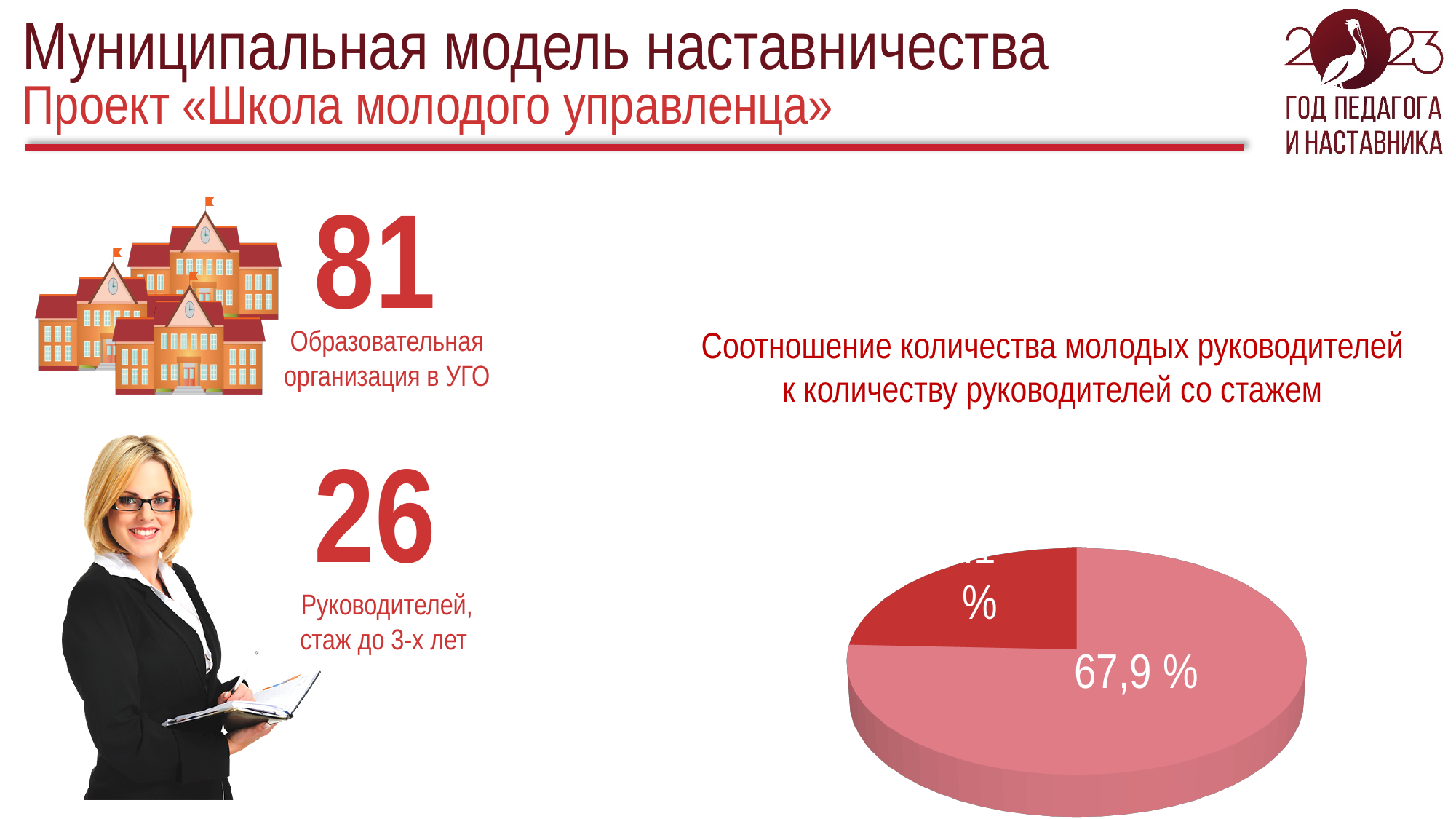
How many slices does the pie chart have? 2 What colour is the slice labelled 67,9 % in the pie chart? light pink What share of the pie does the light pink slice represent? 67,9 % Which slice of the pie chart is larger, the light pink one or the dark red one? the light pink one What value is printed on the large light pink slice of the pie chart? 67,9 % What is the title of the pie chart? Соотношение количества молодых руководителей к количеству руководителей со стажем Which slice of the pie chart is the largest? the light pink slice (67,9 %) Which slice of the pie chart is the smallest? the dark red slice What kind of chart is shown on the slide? pie chart